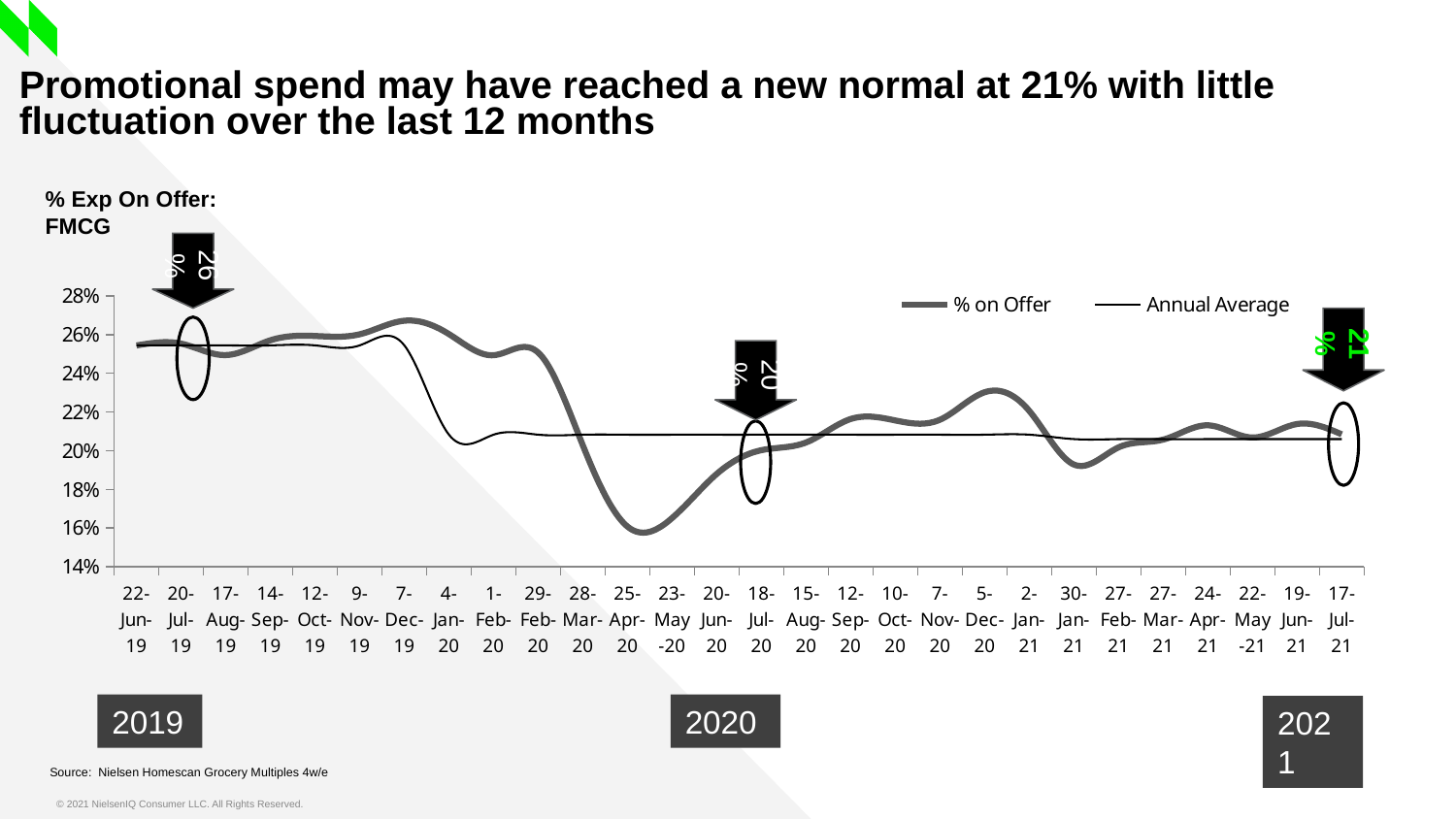
Which annotated annual average is larger, 2019 or 2020? 2019 What is the title of the chart? % Exp On Offer: FMCG Does the % on Offer line rise or fall between 7-Dec-19 and 25-Apr-20? fall How many dated points are labelled along the x axis of the chart? 28 Is the % on Offer value at 25-Apr-20 greater or less than 18%? less What annual average value is annotated in the arrow for 2021? 21% Is the % on Offer value at 22-Jun-19 greater or less than 24%? greater What are the two series named in the chart legend? % on Offer and Annual Average What annual average value is annotated in the arrow for 2019? 26% What kind of chart is shown on the slide? Line chart How many series does the chart legend list? 2 What annual average value is annotated in the arrow for 2020? 20%